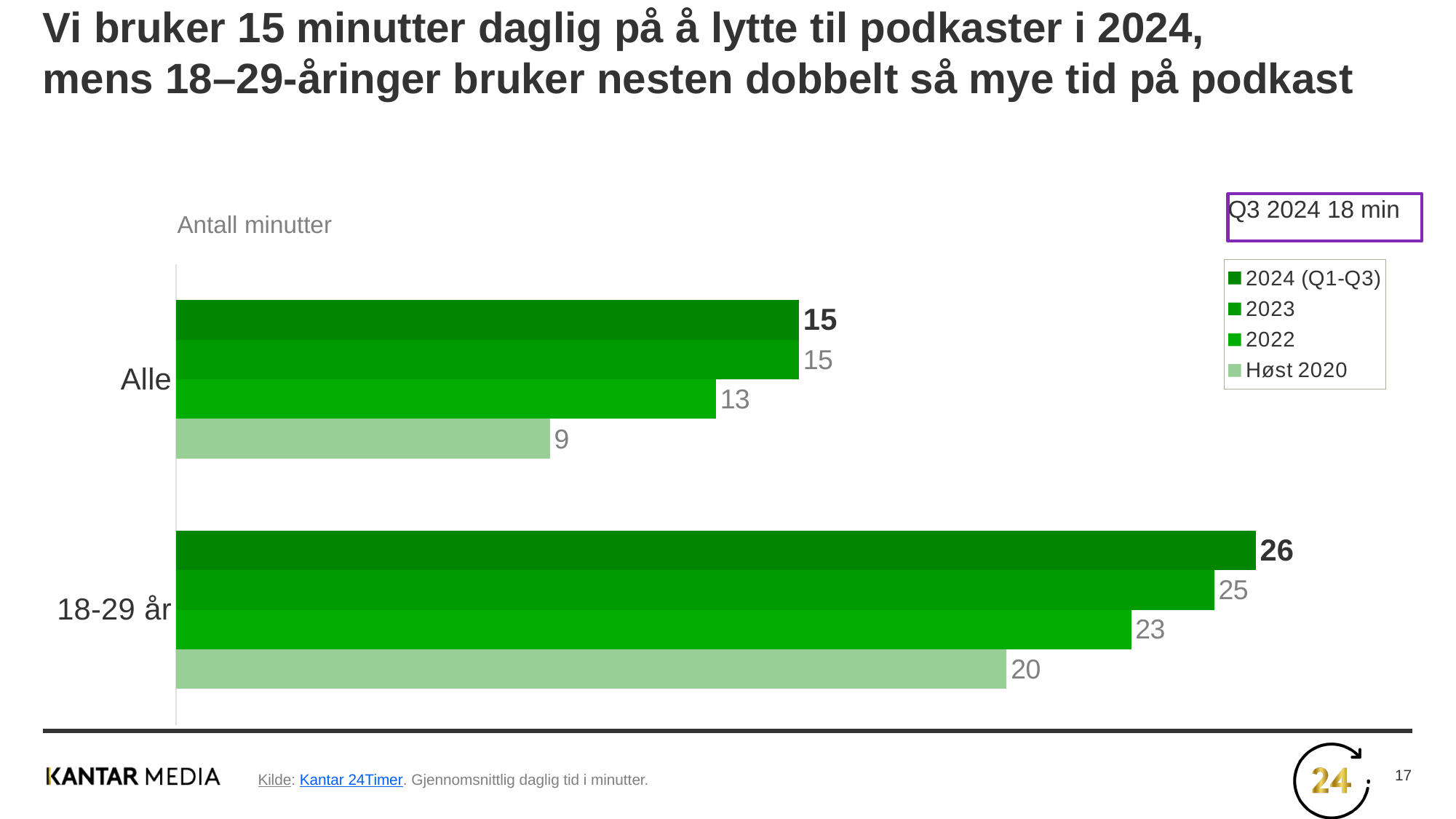
What is the value for 'Alle' in the 2024 (Q1-Q3) series? 15 What is the value for '18-29 år' in the 2023 series? 25 What is the axis label shown above the chart? Antall minutter What is the difference between the 2024 (Q1-Q3) values for '18-29 år' and 'Alle'? 11 Which series has the lowest value for 'Alle'? Høst 2020 What is the value for 'Alle' in the 2022 series? 13 What kind of chart is shown on the slide? Bar chart What is the difference between the 2024 (Q1-Q3) and Høst 2020 values for 'Alle'? 6 What is the value for '18-29 år' in the Høst 2020 series? 20 Which category has the highest value in the 2024 (Q1-Q3) series? 18-29 år How many series does the legend list? 4 Which is larger: the 2022 value for '18-29 år' or the 2023 value for '18-29 år'? 2023